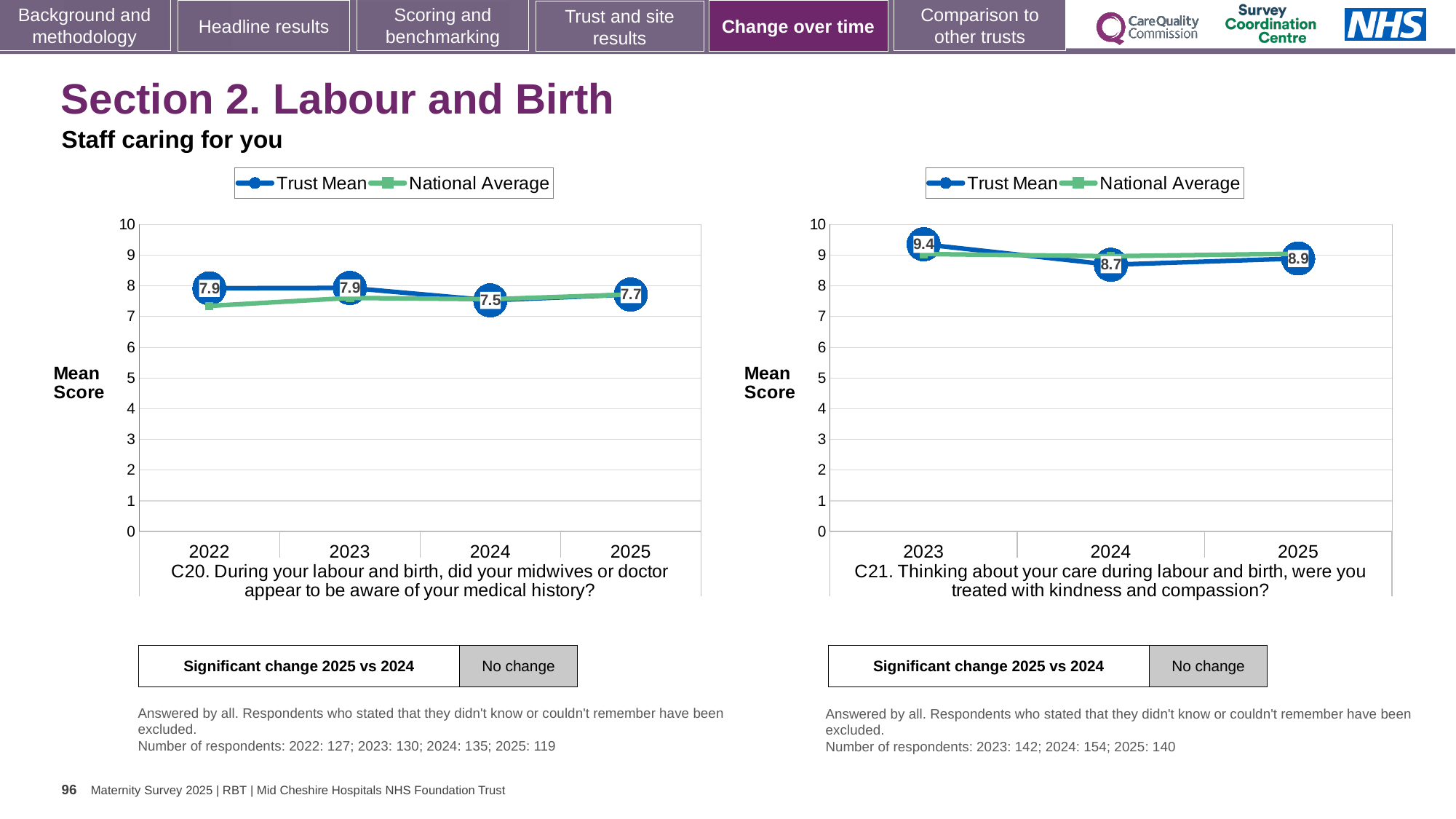
In the left chart (C20), what is the Trust Mean score for 2024? 7.5 In the left chart (C20), is the Trust Mean score higher in 2024 or 2025? 2025 In the left chart (C20), is the National Average for 2022 greater or less than 8? less In the left chart (C20), which year has the lowest Trust Mean score? 2024 In the left chart (C20), what is the Trust Mean score for 2025? 7.7 In the right chart (C21), does the Trust Mean rise or fall from 2024 to 2025? rise In the right chart (C21), what is the difference between the Trust Mean scores for 2023 and 2024? 0.7 In the left chart (C20), what is the difference between the Trust Mean scores for 2022 and 2024? 0.4 In the right chart (C21), what is the Trust Mean score for 2023? 9.4 In the left chart (C20), how many years are shown on the x axis? 4 In the right chart (C21), which year has the lowest Trust Mean score? 2024 How many series does the legend of the right chart (C21) list? 2